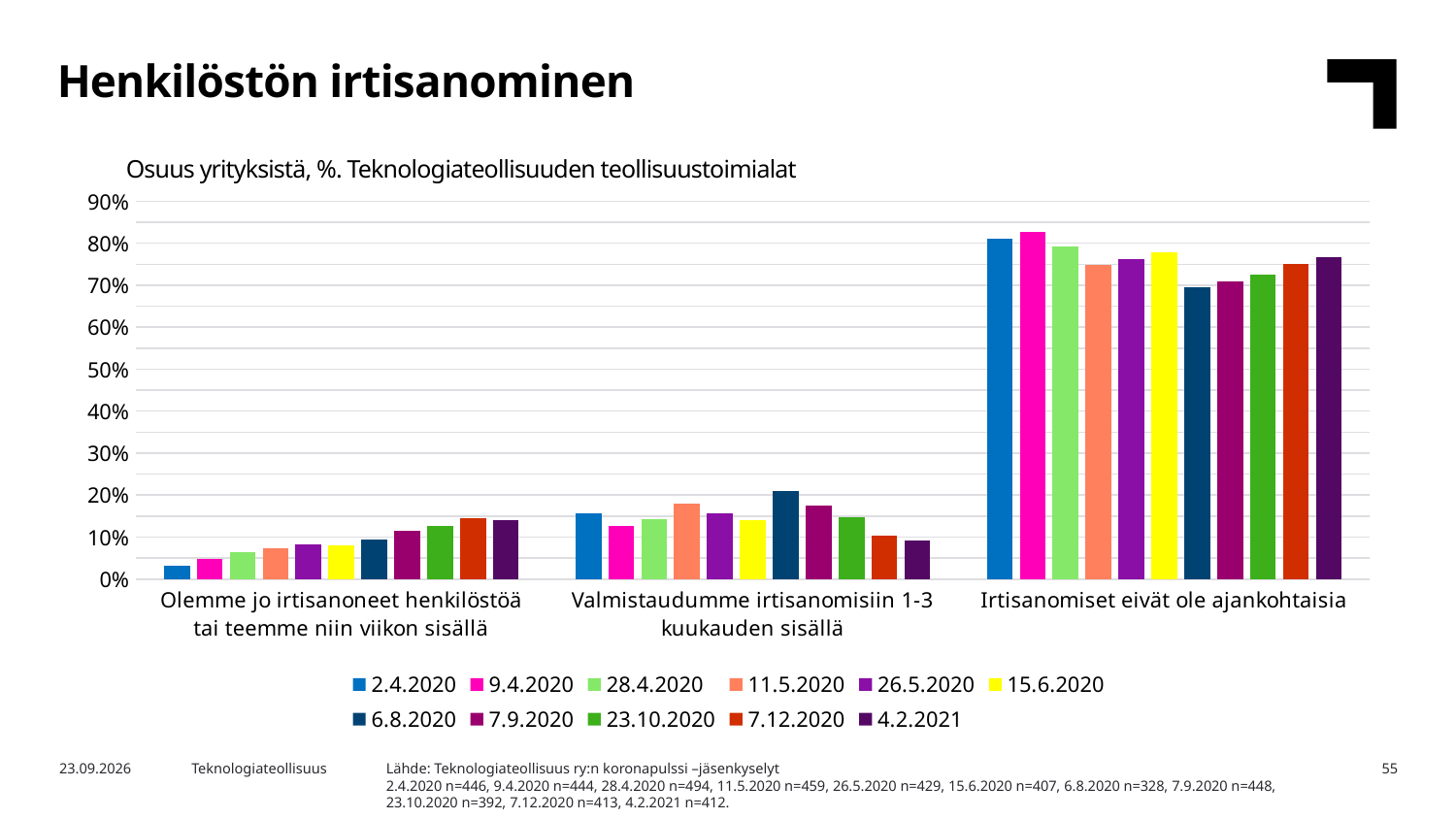
How many series does the chart's legend list? 11 What kind of chart is shown on the slide? bar chart Which category has the highest values in the chart? Irtisanomiset eivät ole ajankohtaisia In the category 'Olemme jo irtisanoneet henkilöstöä tai teemme niin viikon sisällä', which series has the lowest value? 2.4.2020 Is the value for 2.4.2020 in the category 'Olemme jo irtisanoneet henkilöstöä tai teemme niin viikon sisällä' greater or less than 10%? less In the category 'Irtisanomiset eivät ole ajankohtaisia', which is larger: the value for 9.4.2020 or the value for 6.8.2020? 9.4.2020 What is the subtitle text shown above the chart? Osuus yrityksistä, %. Teknologiateollisuuden teollisuustoimialat Is the value for 11.5.2020 in the category 'Irtisanomiset eivät ole ajankohtaisia' greater or less than 80%? less In the category 'Valmistaudumme irtisanomisiin 1-3 kuukauden sisällä', which series has the highest value? 6.8.2020 Is the value for 7.12.2020 in the category 'Olemme jo irtisanoneet henkilöstöä tai teemme niin viikon sisällä' greater or less than 10%? greater How many categories are shown on the x axis of the chart? 3